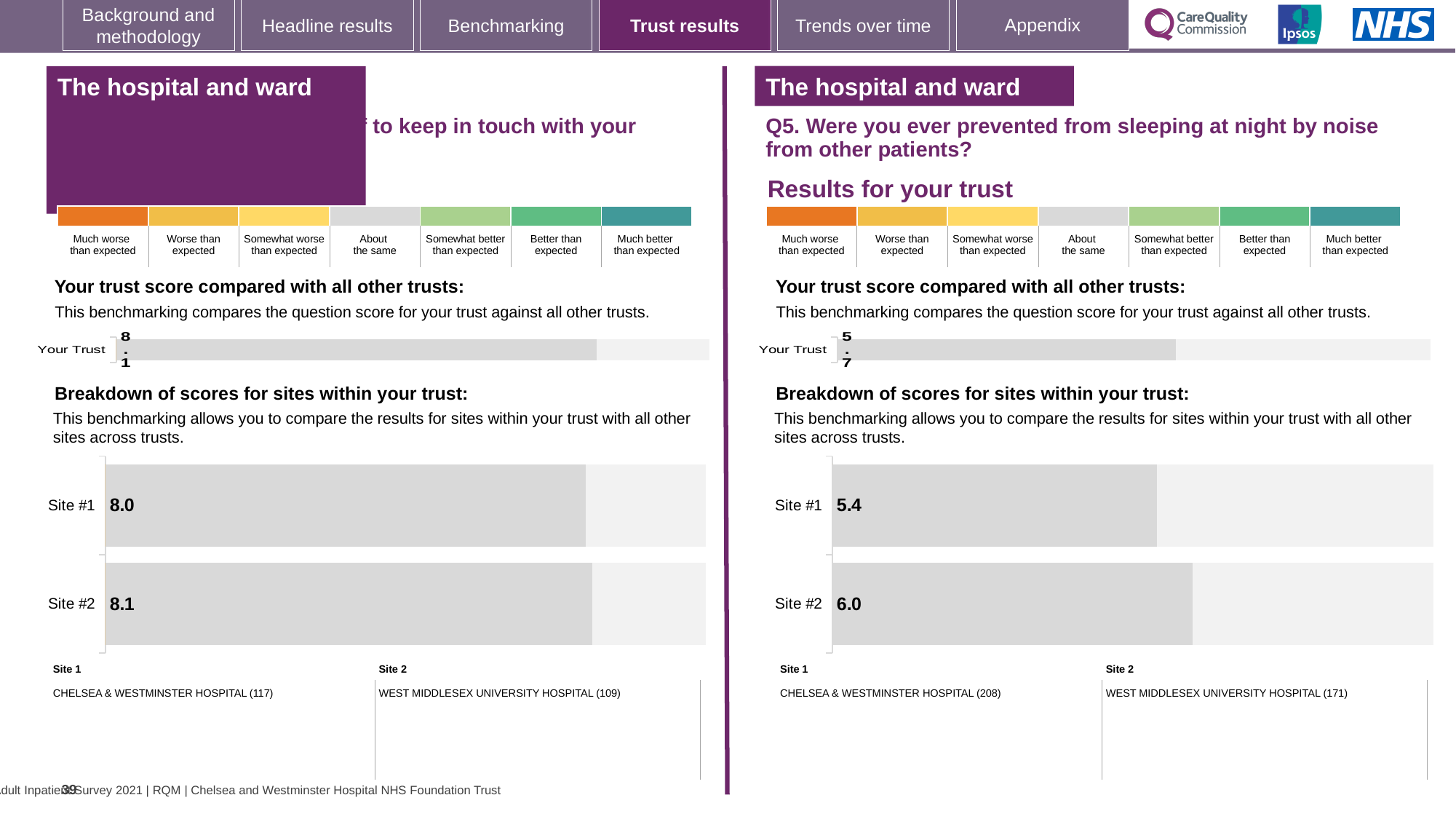
On the left-hand side, what is the 'Your Trust' score compared with all other trusts? 8.1 On the right-hand chart for Q5, which site has the higher score? Site #2 On the right-hand chart for Q5, what is the difference between the Site #2 and Site #1 scores? 0.6 On the left-hand site breakdown chart, what is the score for Site #1? 8.0 On the left-hand site breakdown chart, what is the difference between the Site #2 and Site #1 scores? 0.1 How many sites are shown in the right-hand site breakdown chart for Q5? 2 On the right-hand chart for Q5 (prevented from sleeping at night by noise from other patients), what is the score for Site #1? 5.4 On the right-hand side for Q5, what is the 'Your Trust' score compared with all other trusts? 5.7 On the left-hand site breakdown chart, what is the score for Site #2? 8.1 On the right-hand side for Q5, which hospital is listed as Site 2? West Middlesex University Hospital (171) What type of chart is used for the site breakdown on the right-hand side for Q5? Bar chart On the right-hand chart for Q5, what is the score for Site #2? 6.0